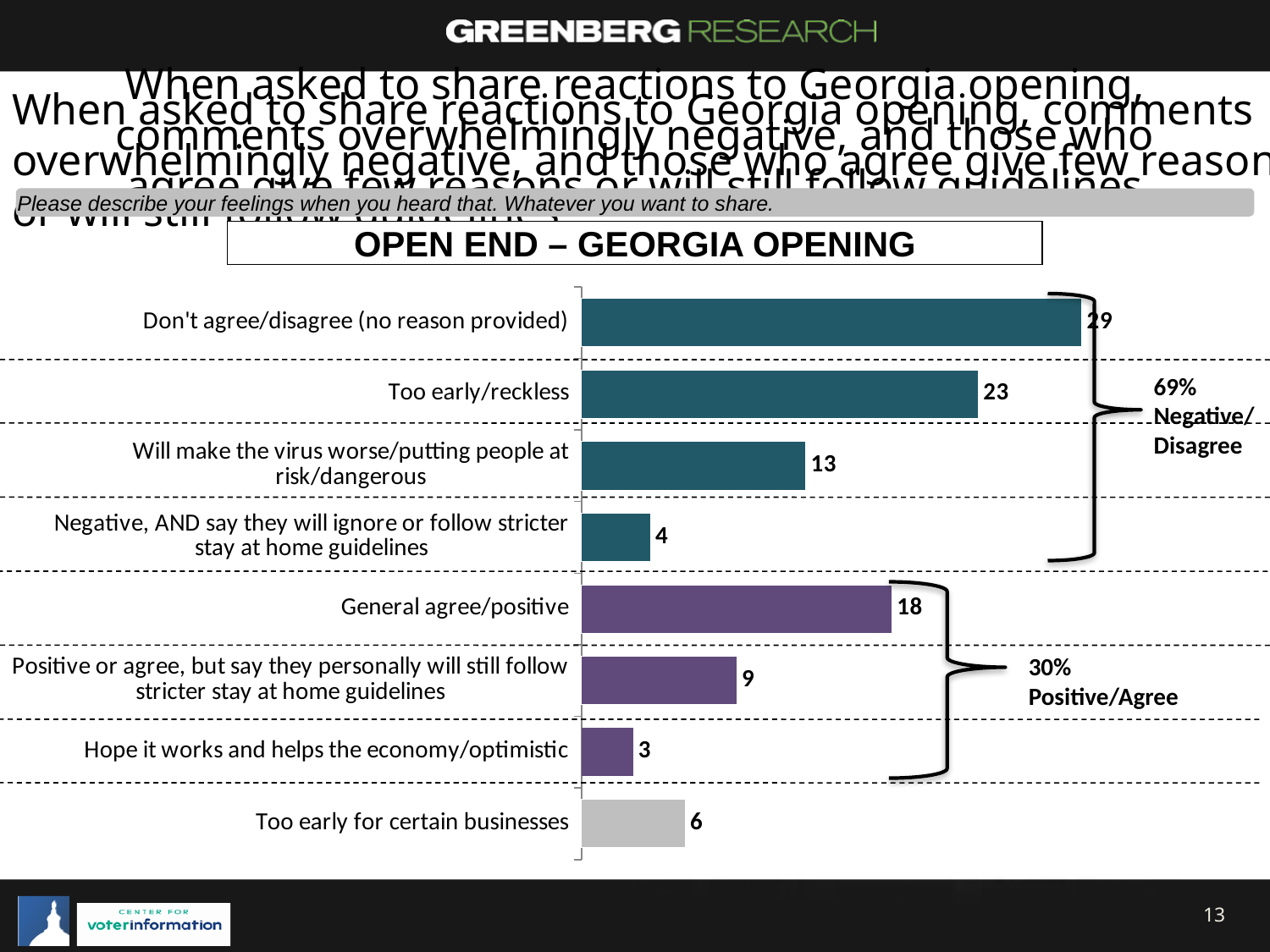
What is the difference between the values for "Don't agree/disagree (no reason provided)" and "Too early/reckless"? 6 What is the value for "Too early/reckless"? 23 What is the title of the chart? OPEN END – GEORGIA OPENING What is the value for "General agree/positive"? 18 Which category has the lowest value? Hope it works and helps the economy/optimistic What is the difference between the values for "General agree/positive" and "Positive or agree, but say they personally will still follow stricter stay at home guidelines"? 9 What kind of chart is shown on the slide? Bar chart Which is larger: the value for "Will make the virus worse/putting people at risk/dangerous" or the value for "General agree/positive"? General agree/positive What is the value for "Too early for certain businesses"? 6 How many categories are shown in the chart? 8 Which category has the highest value? Don't agree/disagree (no reason provided) What percentage does the bracket label give for the Negative/Disagree group? 69%